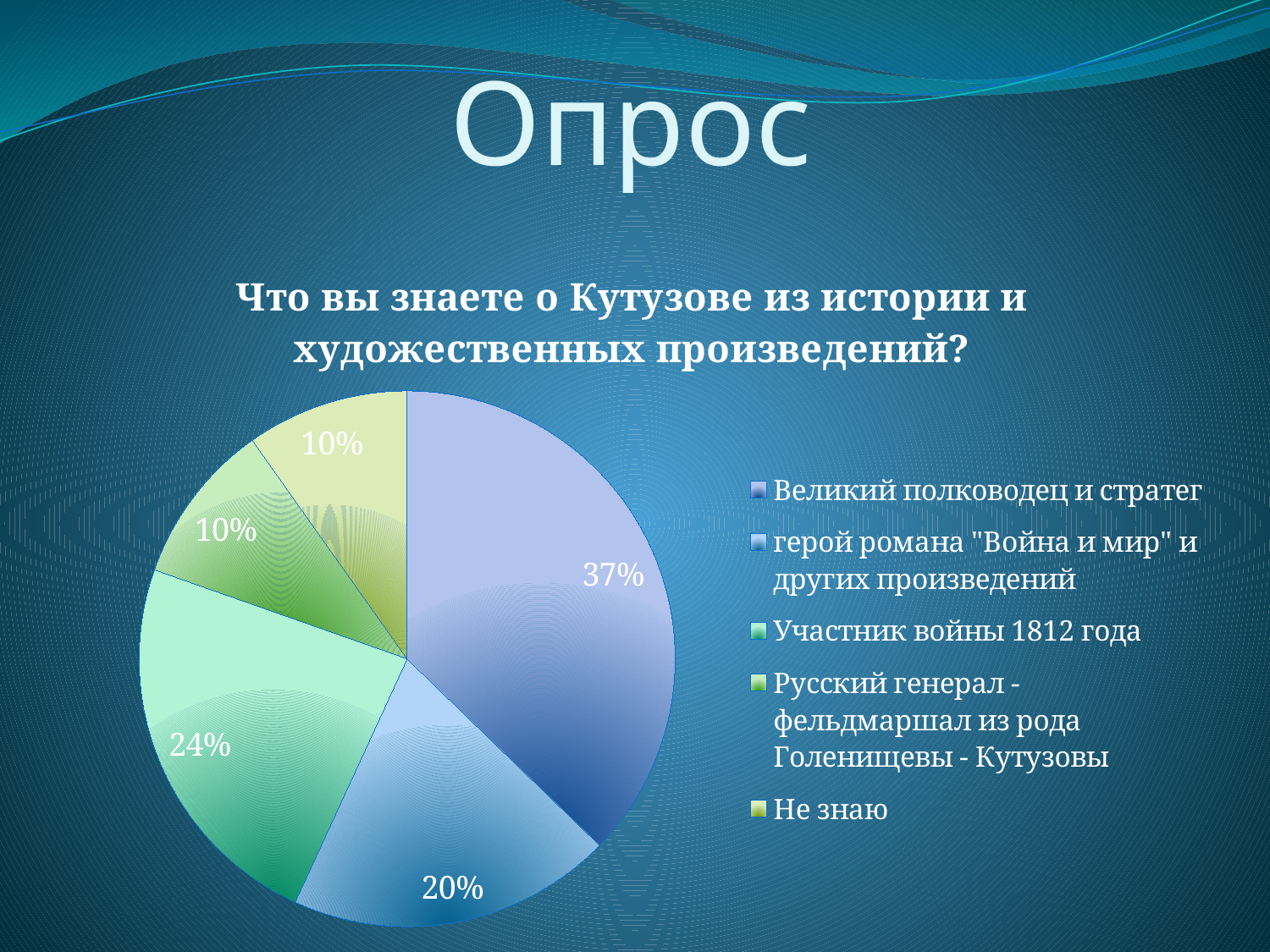
What share of the pie is labelled "герой романа "Война и мир" и других произведений"? 20% Which category has the largest share of the pie? Великий полководец и стратег What is the difference between the shares for "Великий полководец и стратег" and "Участник войны 1812 года"? 13% How many entries does the legend list? 5 How many slices does the pie chart have? 5 What share of the pie is labelled "Великий полководец и стратег"? 37% What is the title of the chart? Что вы знаете о Кутузове из истории и художественных произведений? What share of the pie is labelled "Не знаю"? 10% What kind of chart is shown on the slide? pie chart What is the combined share of "Русский генерал - фельдмаршал из рода Голенищевы - Кутузовы" and "Не знаю"? 20% Which is larger: the share for "Участник войны 1812 года" or the share for "герой романа "Война и мир" и других произведений"? Участник войны 1812 года